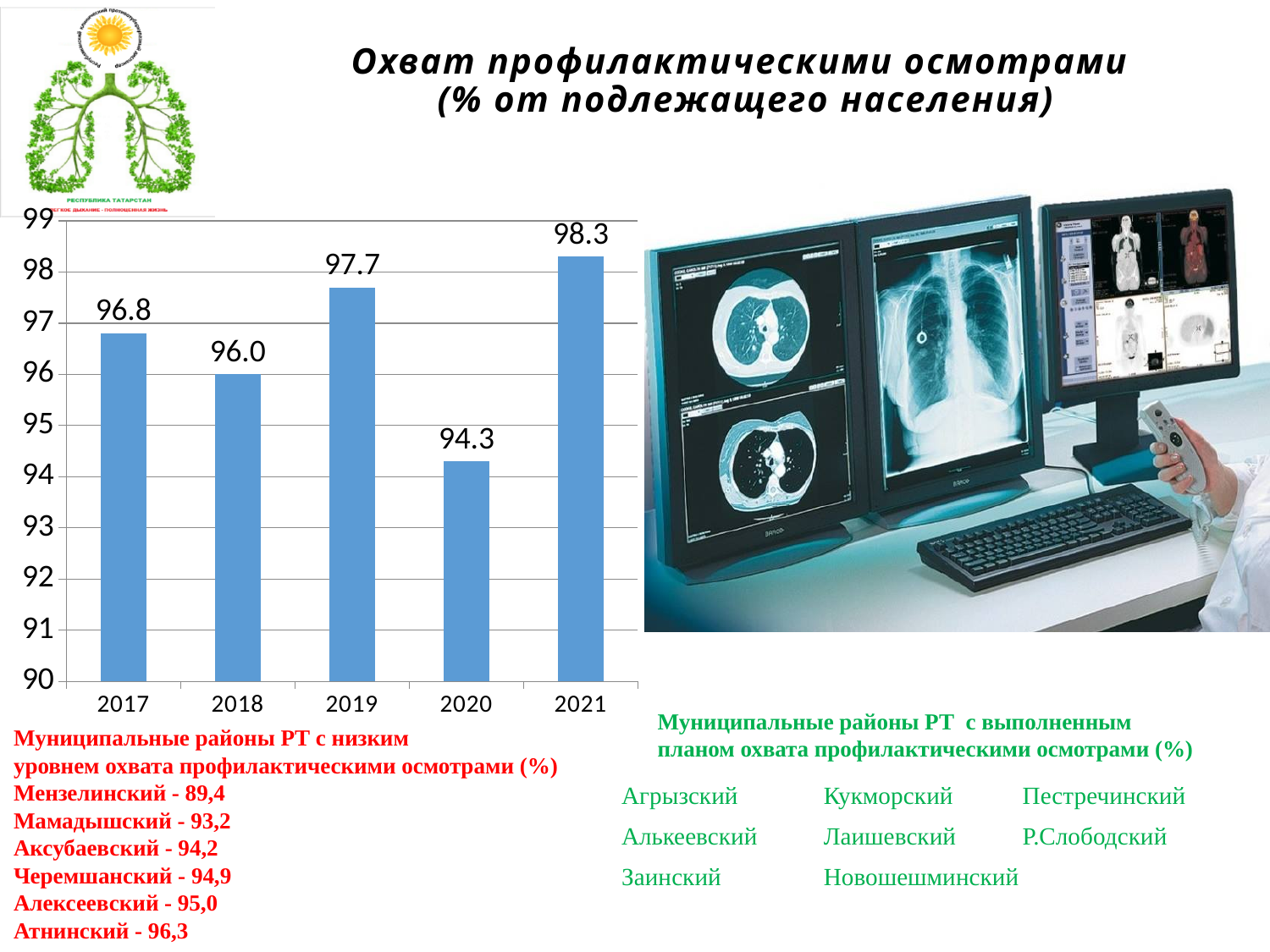
Which year has the lowest value? 2020 What is the difference between the values for 2019 and 2018? 1.7 What is the value for 2020? 94.3 How many years are shown on the x axis? 5 What kind of chart is shown on the slide? bar chart Does the value rise or fall from 2019 to 2020? fall Which is larger, the value for 2017 or the value for 2018? 2017 What is the value for 2017? 96.8 What is the difference between the values for 2021 and 2020? 4.0 What is the value for 2021? 98.3 Which year has the highest value? 2021 Is the value for 2020 greater or less than 95? less